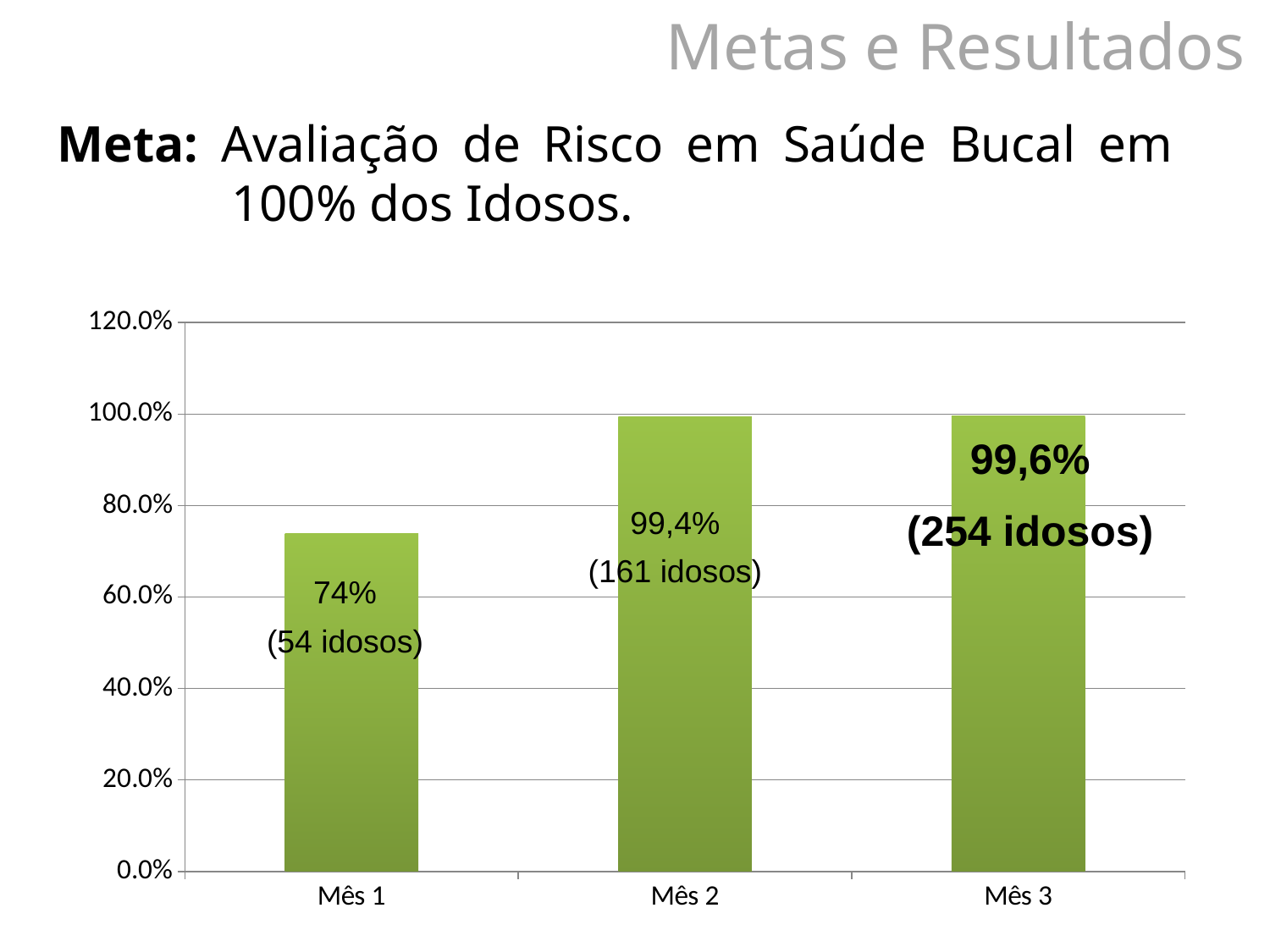
Which month has the lowest value? Mês 1 What is the value for Mês 1? 74% What is the value for Mês 2? 99,4% Which is larger, the value for Mês 1 or the value for Mês 2? Mês 2 Which month has the highest value according to the data labels? Mês 3 How many idosos are shown in the label for Mês 3? 254 idosos What is the value for Mês 3? 99,6% How many months are shown on the x axis? 3 Is the value for Mês 1 greater or less than 80.0%? less How many idosos are shown in the label for Mês 1? 54 idosos What kind of chart is shown on the slide? bar chart What is the difference in percentage between Mês 2 and Mês 1? 25,4%